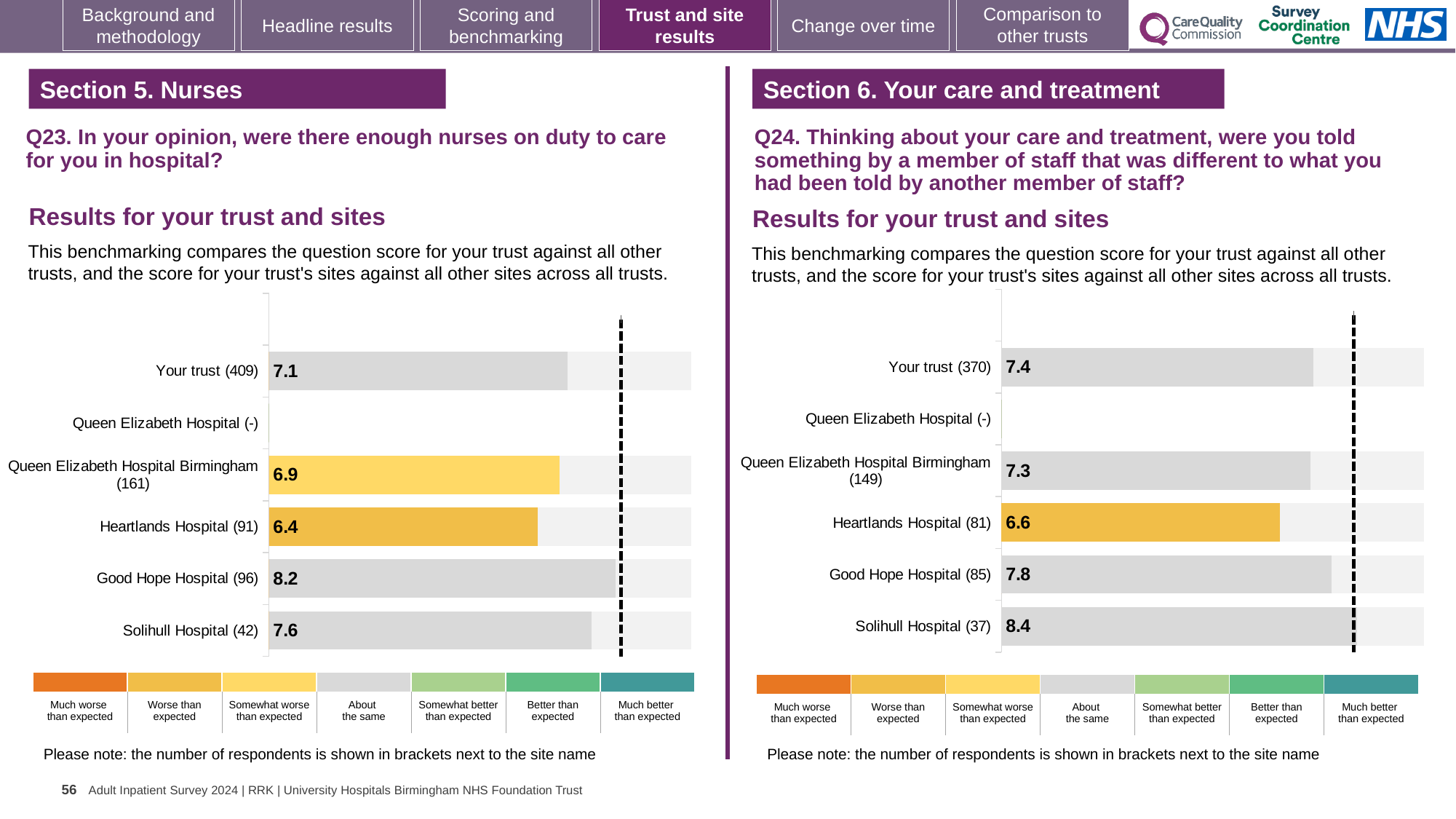
In the Q23 chart on the left, which bar is coloured orange (worse than expected)? Heartlands Hospital (91) In the Q24 chart on the right, which is larger, the score for Your trust or the score for Good Hope Hospital? Good Hope Hospital In the Q23 chart on the left, which site has the lowest score? Heartlands Hospital (91) In the Q24 chart on the right, which site has the lowest score? Heartlands Hospital (81) What kind of chart is used for the Q23 results on the left? Bar chart In the Q23 chart on the left, what is the score for Your trust (409)? 7.1 In the Q23 chart on the left, which site has the highest score? Good Hope Hospital (96) In the Q24 chart on the right, what is the score for Queen Elizabeth Hospital Birmingham (149)? 7.3 In the Q23 chart on the left, what is the score for Heartlands Hospital (91)? 6.4 In the Q24 chart on the right, what is the difference between the scores for Solihull Hospital and Heartlands Hospital? 1.8 In the Q23 chart on the left, what is the difference between the scores for Good Hope Hospital and Solihull Hospital? 0.6 In the Q24 chart on the right, what is the score for Solihull Hospital (37)? 8.4